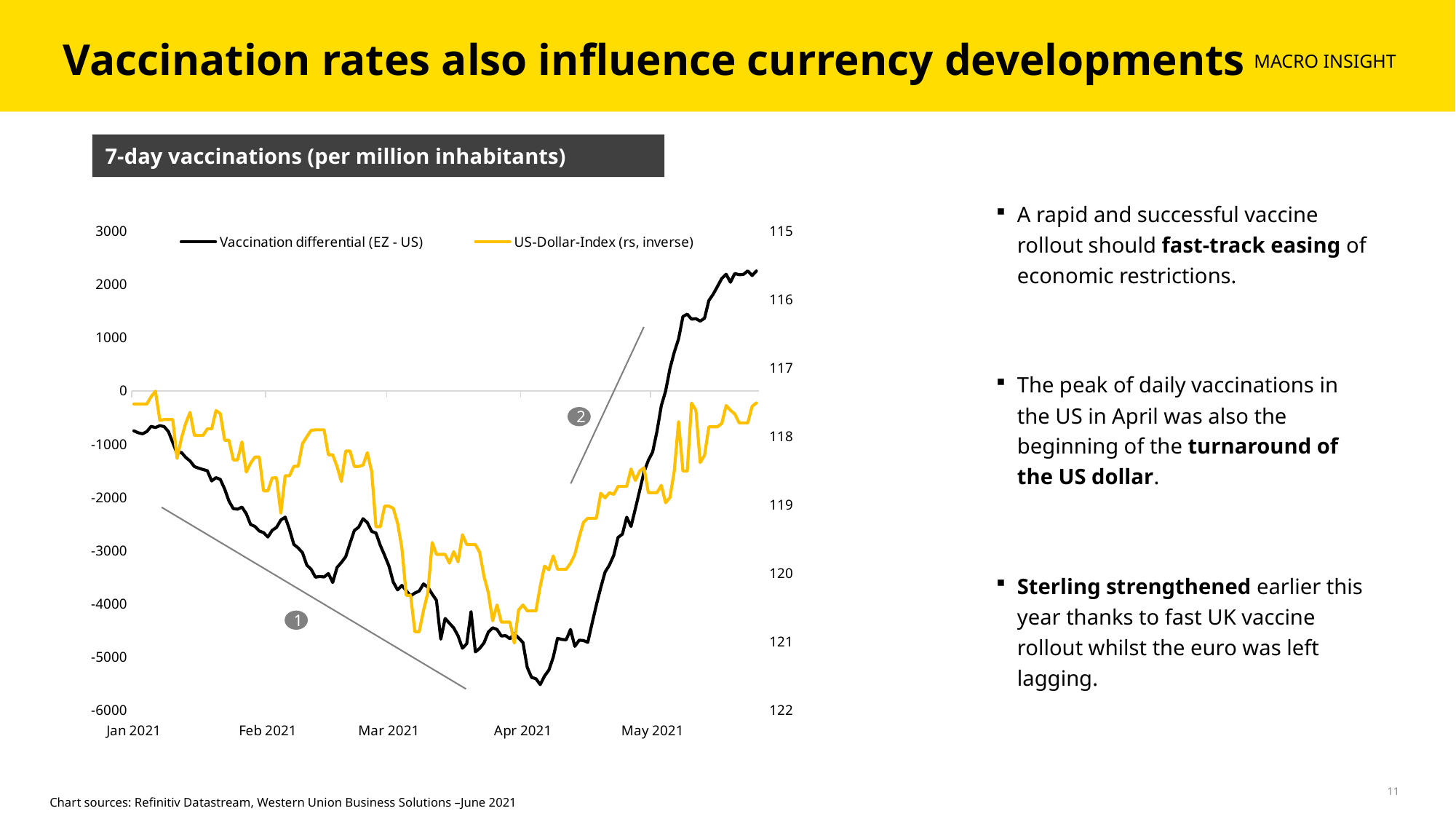
What is the highest tick value shown on the right axis? 122 How many series does the chart legend list? 2 How many month labels are shown on the x axis? 5 Which series is drawn in yellow? US-Dollar-Index (rs, inverse) What is the title of the chart? 7-day vaccinations (per million inhabitants) Is the value of the Vaccination differential (EZ - US) at the end of the series in May 2021 greater or less than 1000? greater Does the Vaccination differential (EZ - US) line rise or fall between Jan 2021 and late Mar 2021? fall What is the lowest tick value shown on the left axis? -6000 Does the Vaccination differential (EZ - US) line rise or fall between Apr 2021 and May 2021? rise What kind of chart is shown on the slide? line chart Is the value of the Vaccination differential (EZ - US) at the start of Jan 2021 greater or less than 0? less Is the lowest value of the Vaccination differential (EZ - US) line greater or less than -5000? less